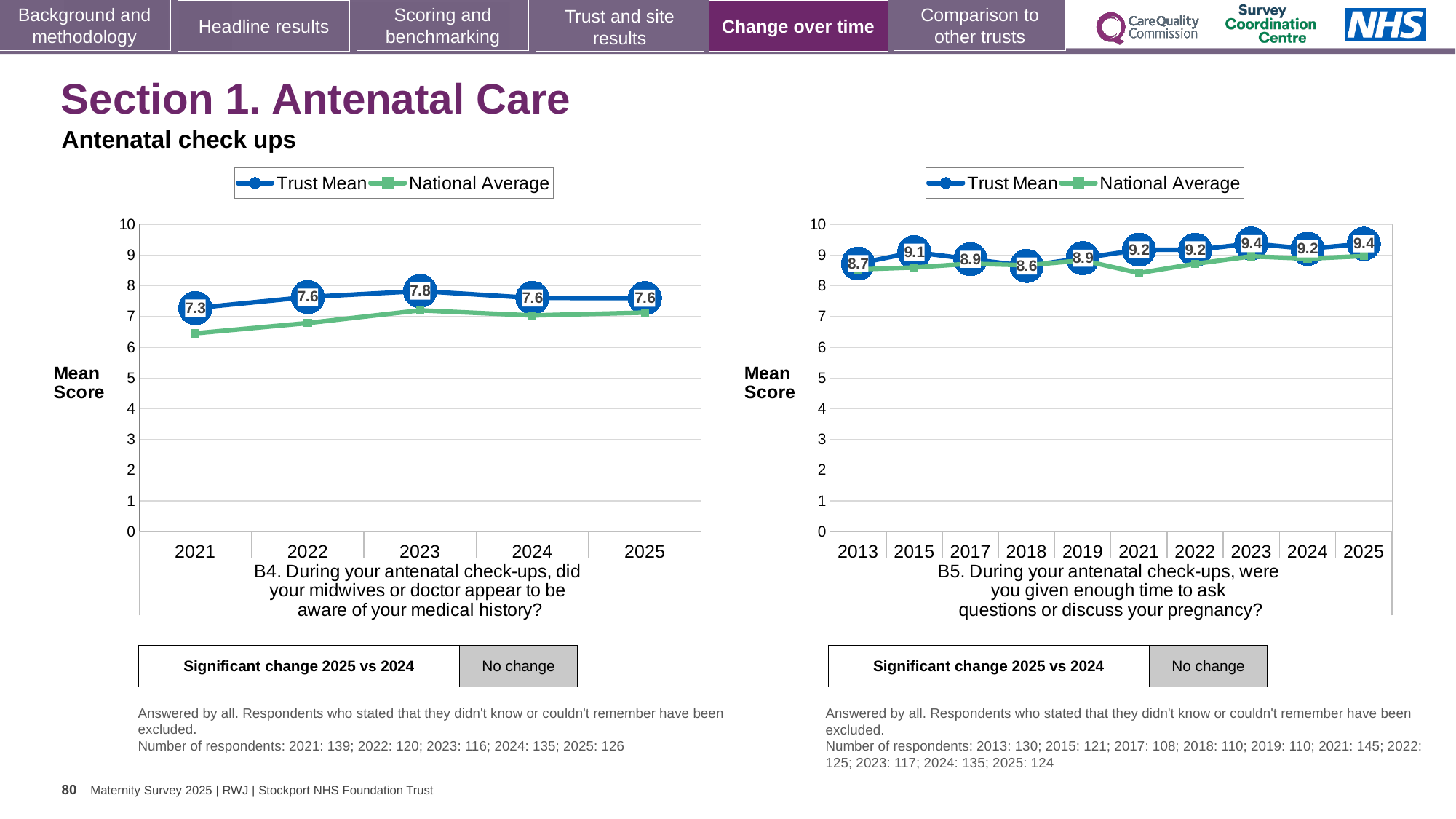
In the right chart (B5), which year has the lowest Trust Mean score? 2018 In the right chart (B5), which is larger: the Trust Mean score for 2015 or for 2018? 2015 In the left chart (B4), is the National Average value for 2021 greater or less than 7? less In the right chart (B5), is the National Average value for 2021 greater or less than 8? greater In the left chart (B4), what is the Trust Mean score for 2023? 7.8 How many series does the legend of the left chart (B4) list? 2 In the right chart (B5), what is the difference between the Trust Mean scores for 2025 and 2013? 0.7 In the left chart (B4), which year has the highest Trust Mean score? 2023 What type of chart is the left chart (B4)? Line chart In the right chart (B5), what is the Trust Mean score for 2018? 8.6 In the left chart (B4), what is the difference between the Trust Mean scores for 2023 and 2021? 0.5 How many years are shown on the x axis of the right chart (B5)? 10